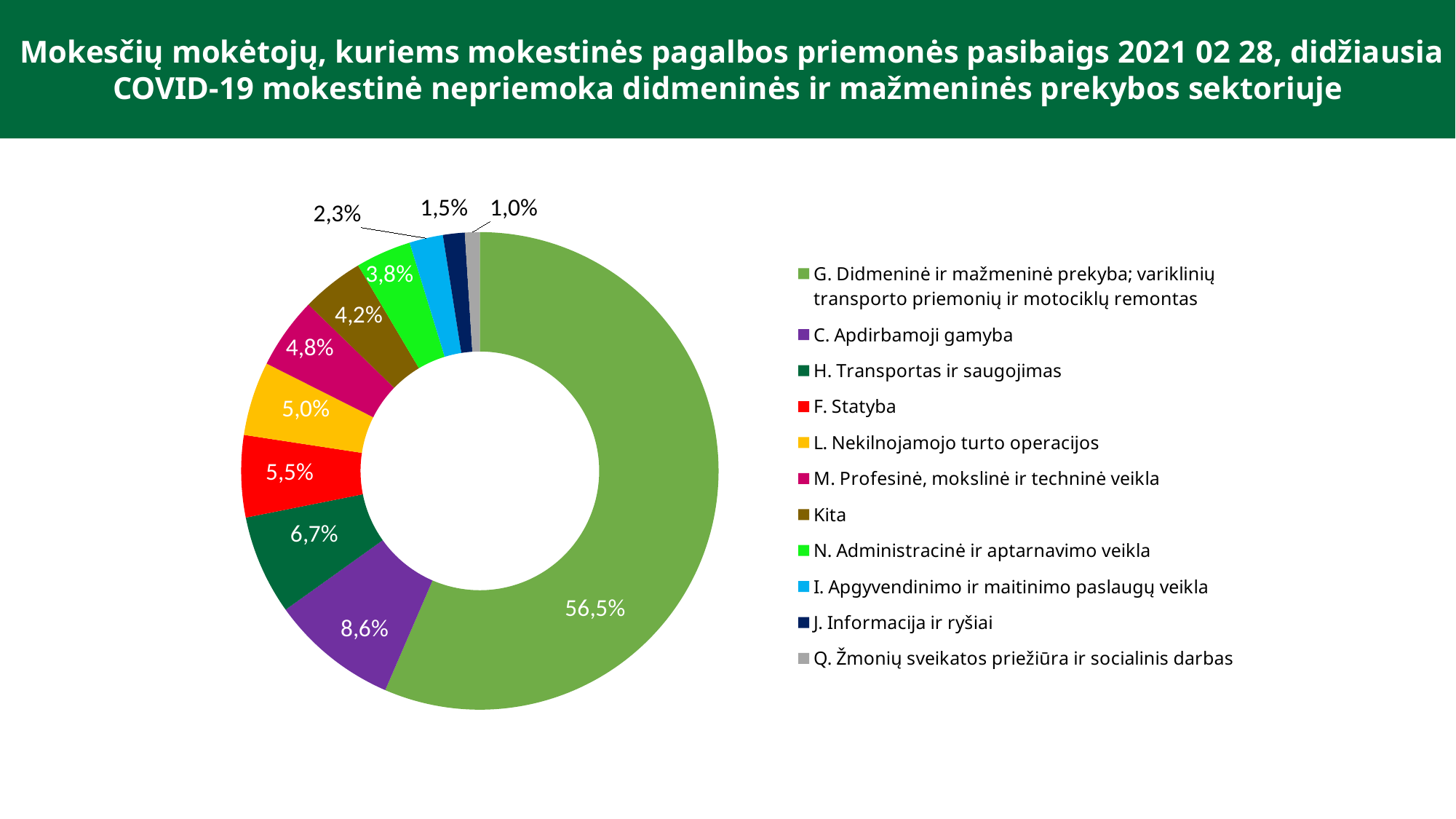
What is the difference between the shares of "C. Apdirbamoji gamyba" and "H. Transportas ir saugojimas"? 1,9% What is the value for "C. Apdirbamoji gamyba"? 8,6% What share does "G. Didmeninė ir mažmeninė prekyba; variklinių transporto priemonių ir motociklų remontas" have? 56,5% How many categories does the chart show? 11 What colour is the slice for "F. Statyba"? Red What is the value for "F. Statyba"? 5,5% Which is larger: the share of "L. Nekilnojamojo turto operacijos" or "N. Administracinė ir aptarnavimo veikla"? L. Nekilnojamojo turto operacijos Which category has the smallest share? Q. Žmonių sveikatos priežiūra ir socialinis darbas Which category has the largest share? G. Didmeninė ir mažmeninė prekyba; variklinių transporto priemonių ir motociklų remontas What kind of chart is shown on the slide? Pie chart (doughnut) What is the value for "J. Informacija ir ryšiai"? 1,5% What is the value for "Kita"? 4,2%